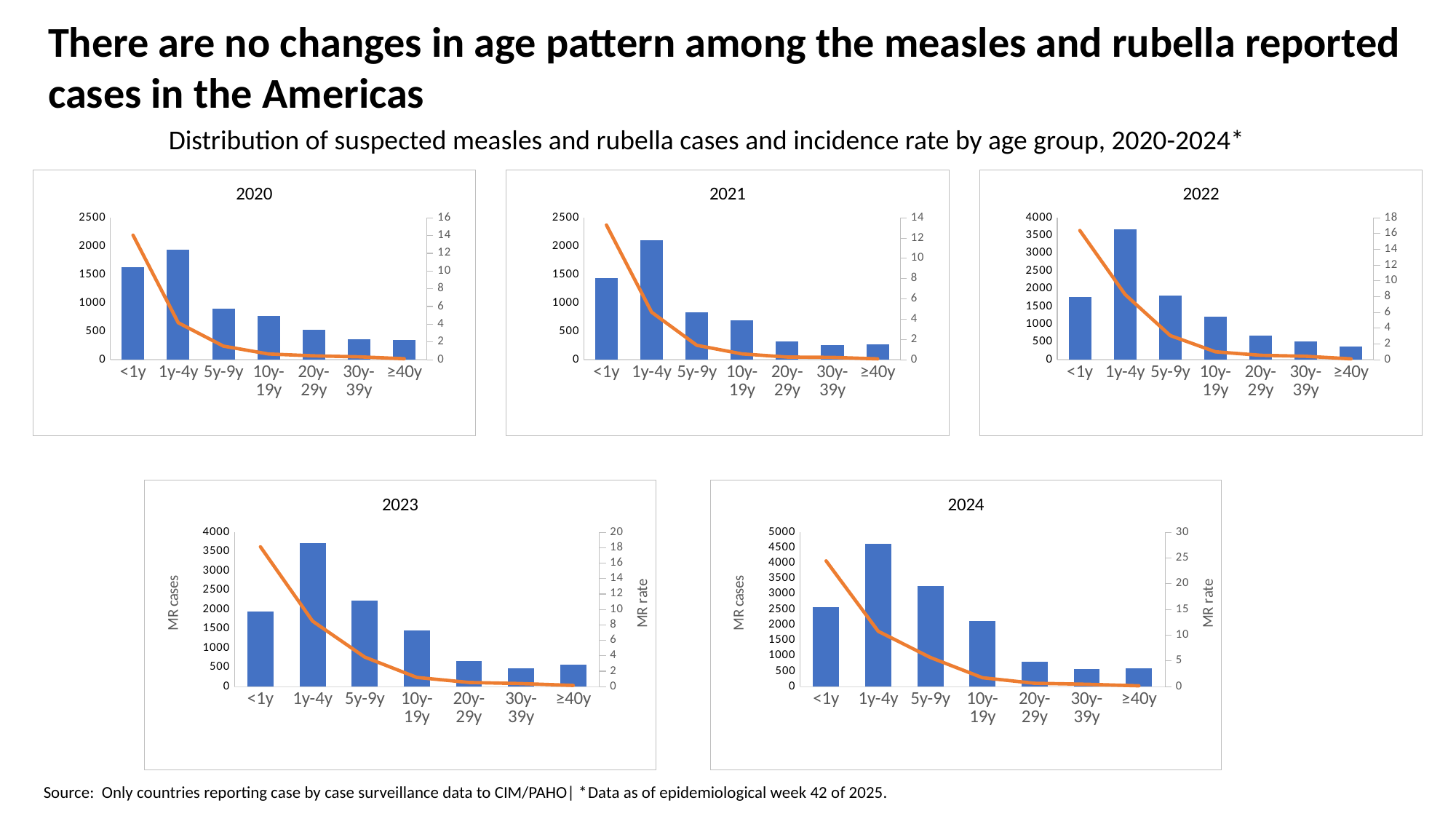
In the 2024 chart, is the bar for 5y-9y greater or less than 3000? greater In the 2024 chart, which bar is taller, <1y or 5y-9y? 5y-9y In the 2023 chart, is the bar for 5y-9y greater or less than 2000? greater In the 2020 chart, which age group has the tallest bar? 1y-4y In the 2023 chart, which bar is taller, <1y or 5y-9y? 5y-9y In the 2022 chart, which age group has the shortest bar? ≥40y In the 2022 chart, is the bar for 1y-4y greater or less than 3500? greater How many age groups are shown on the x axis of the 2024 chart? 7 In the 2021 chart, does the orange line rise or fall from <1y to ≥40y? fall In the 2021 chart, which age group has the tallest bar? 1y-4y What is the label on the right-hand vertical axis of the 2024 chart? MR rate